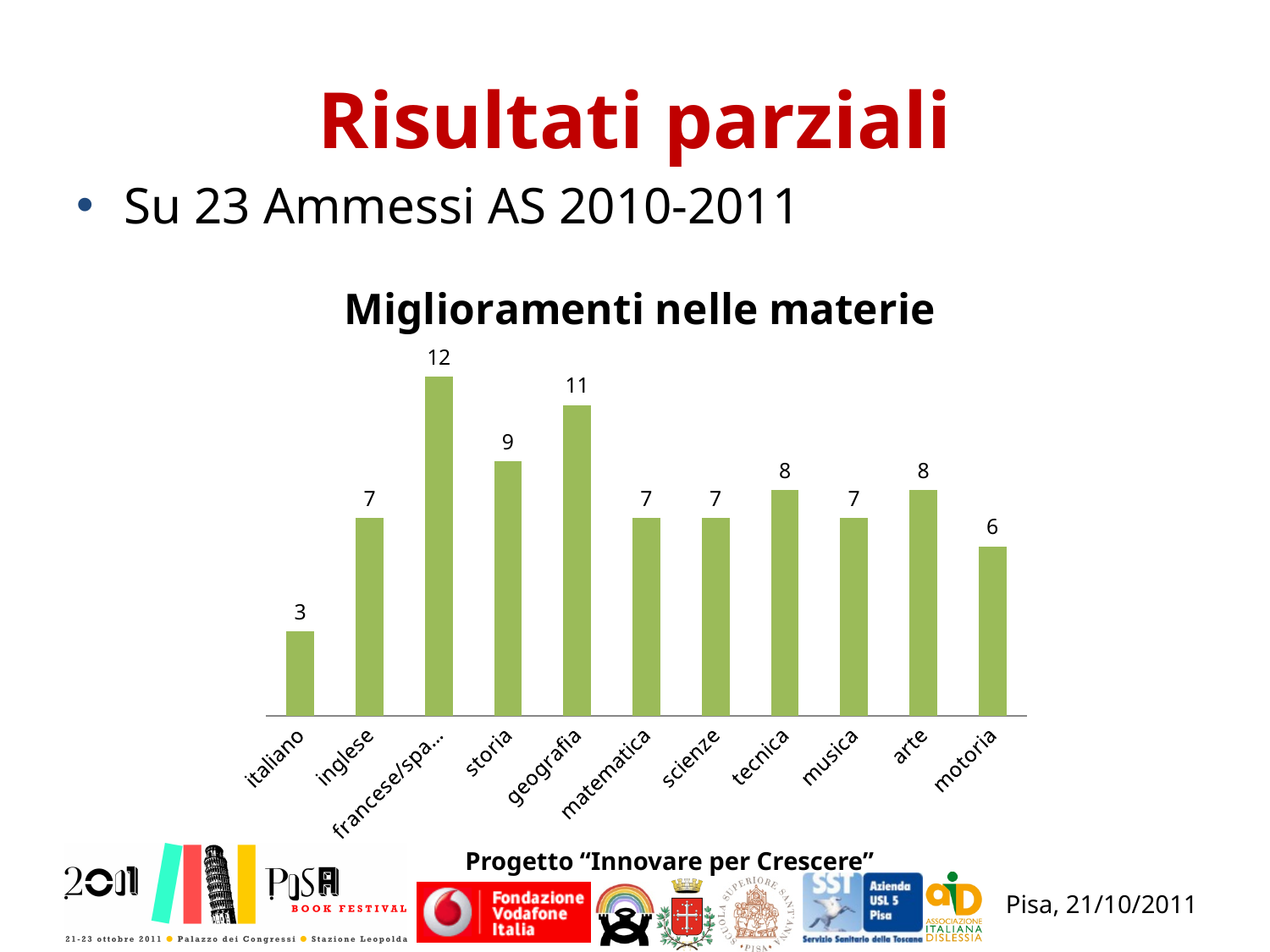
What kind of chart is this? bar chart What is the title of the chart? Miglioramenti nelle materie Which is larger, the value for arte or the value for motoria? arte Which category has the lowest value? italiano Which category has the highest value? francese/spa... Which is larger, the value for tecnica or the value for musica? tecnica What is the difference between the values for storia and inglese? 2 How many categories are shown on the x axis? 11 What is the value for motoria? 6 What is the value for geografia? 11 What is the value for italiano? 3 What is the difference between the values for francese/spa... and italiano? 9